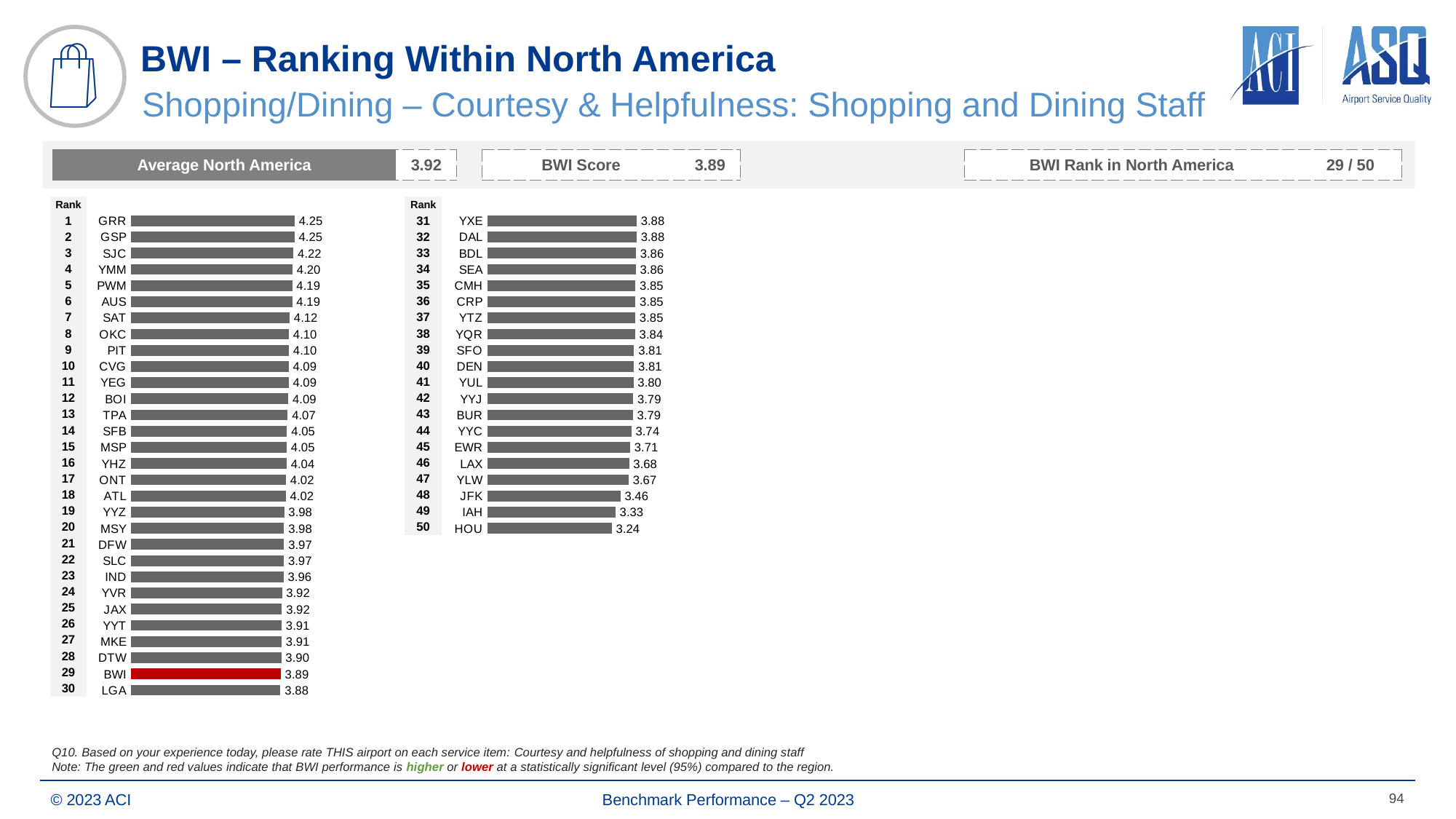
How many airports are ranked in the right-hand chart (ranks 31-50)? 20 How many airports are ranked in the left-hand chart (ranks 1-30)? 30 Which has a higher score, ATL or LAX? ATL What is the difference between the BWI score and the Average North America score? 0.03 What is the score for BWI in the ranking chart? 3.89 What is the difference between the scores of GRR and HOU? 1.01 Which airport has the lowest score across the ranking charts? HOU Which airport's bar is highlighted in red in the left-hand chart? BWI What is the score for SFO in the right-hand chart (ranks 31-50)? 3.81 What is BWI's rank in North America as shown on the slide? 29 / 50 What is the score for the top-ranked airport, GRR, in the left-hand chart? 4.25 What type of chart is used to show the airport rankings? Bar chart